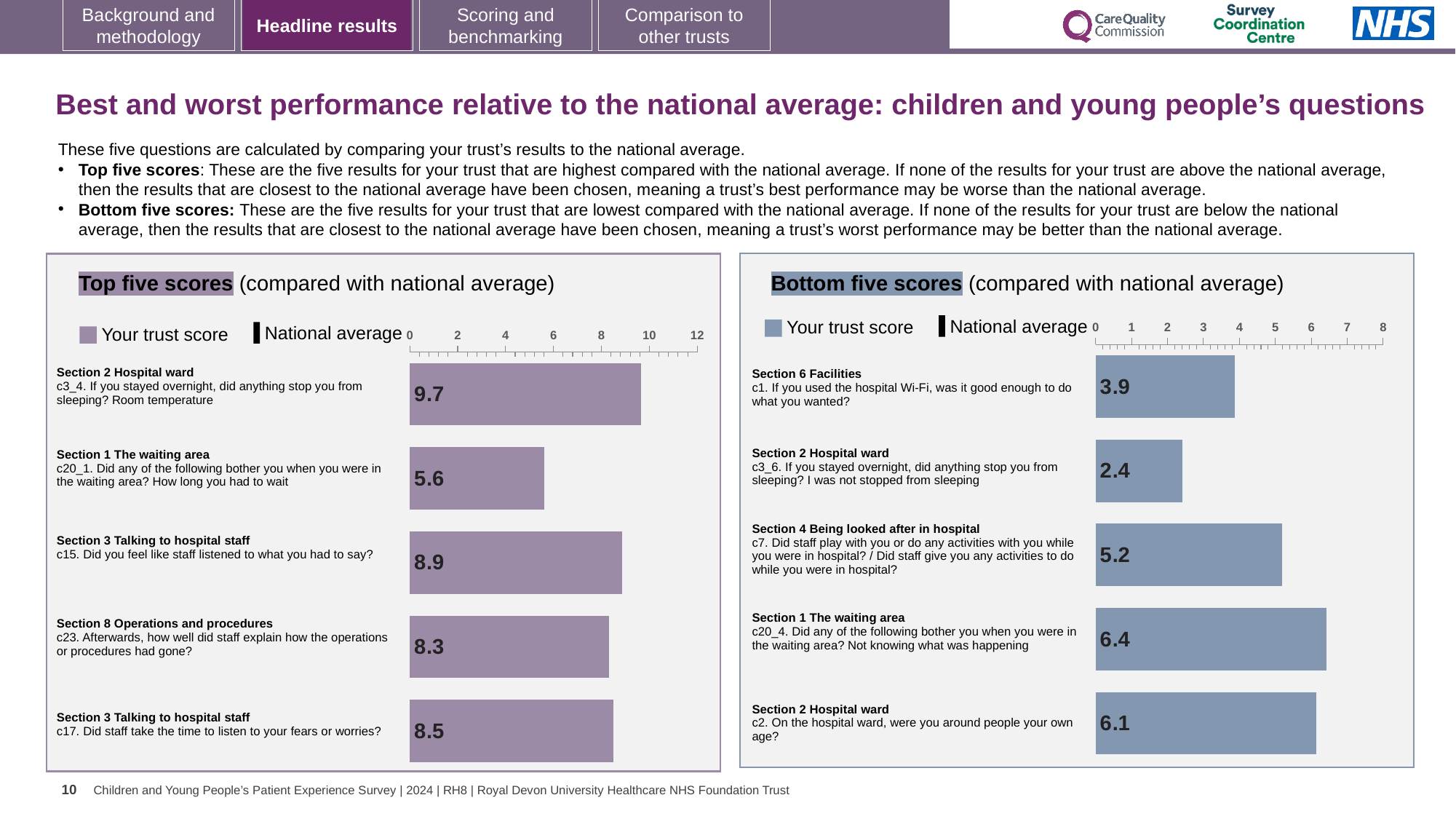
In the Bottom five scores chart, what is the trust score for c1 (If you used the hospital Wi-Fi, was it good enough to do what you wanted?)? 3.9 What type of chart is the Top five scores chart? Bar chart In the Bottom five scores chart, what is the difference between the trust scores for c20_4 and c3_6? 4.0 In the Top five scores chart, what is the trust score for c20_1 (How long you had to wait in the waiting area)? 5.6 In the Top five scores chart, which question has the highest trust score? c3_4. If you stayed overnight, did anything stop you from sleeping? Room temperature What is the maximum value shown on the x axis of the Bottom five scores chart? 8 In the Top five scores chart, what is the difference between the trust scores for c15 and c23? 0.6 In the Bottom five scores chart, which question has the lowest trust score? c3_6. If you stayed overnight, did anything stop you from sleeping? I was not stopped from sleeping In the Top five scores chart, what is the trust score for c3_4 (If you stayed overnight, did anything stop you from sleeping? Room temperature)? 9.7 In the Top five scores chart, which has the larger trust score: c17 or c23? c17 In the Bottom five scores chart, what is the trust score for c20_4 (Not knowing what was happening in the waiting area)? 6.4 How many questions are shown in the Bottom five scores chart? 5